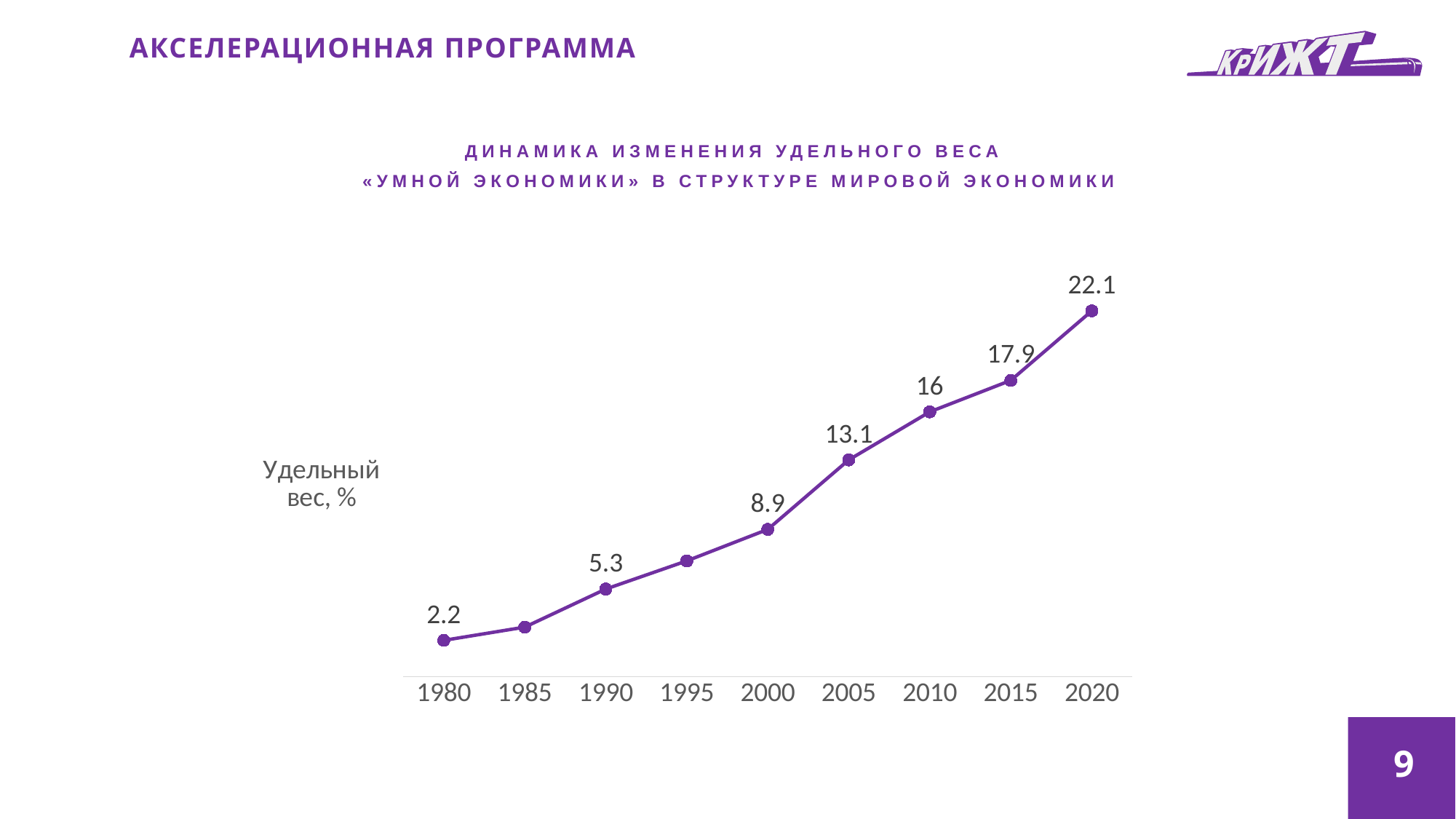
How many data points are plotted on the chart? 9 What is the value for 1980? 2.2 What is the value for 2005? 13.1 What is the value for 2010? 16 Which year has the highest value? 2020 What is the difference between the values for 2000 and 1990? 3.6 What is the value for 1990? 5.3 What is the value for 2020? 22.1 Which year has the lowest value? 1980 What is the difference between the values for 2020 and 2015? 4.2 What kind of chart is shown on the slide? line chart Which is larger, the value for 2005 or the value for 2000? 2005